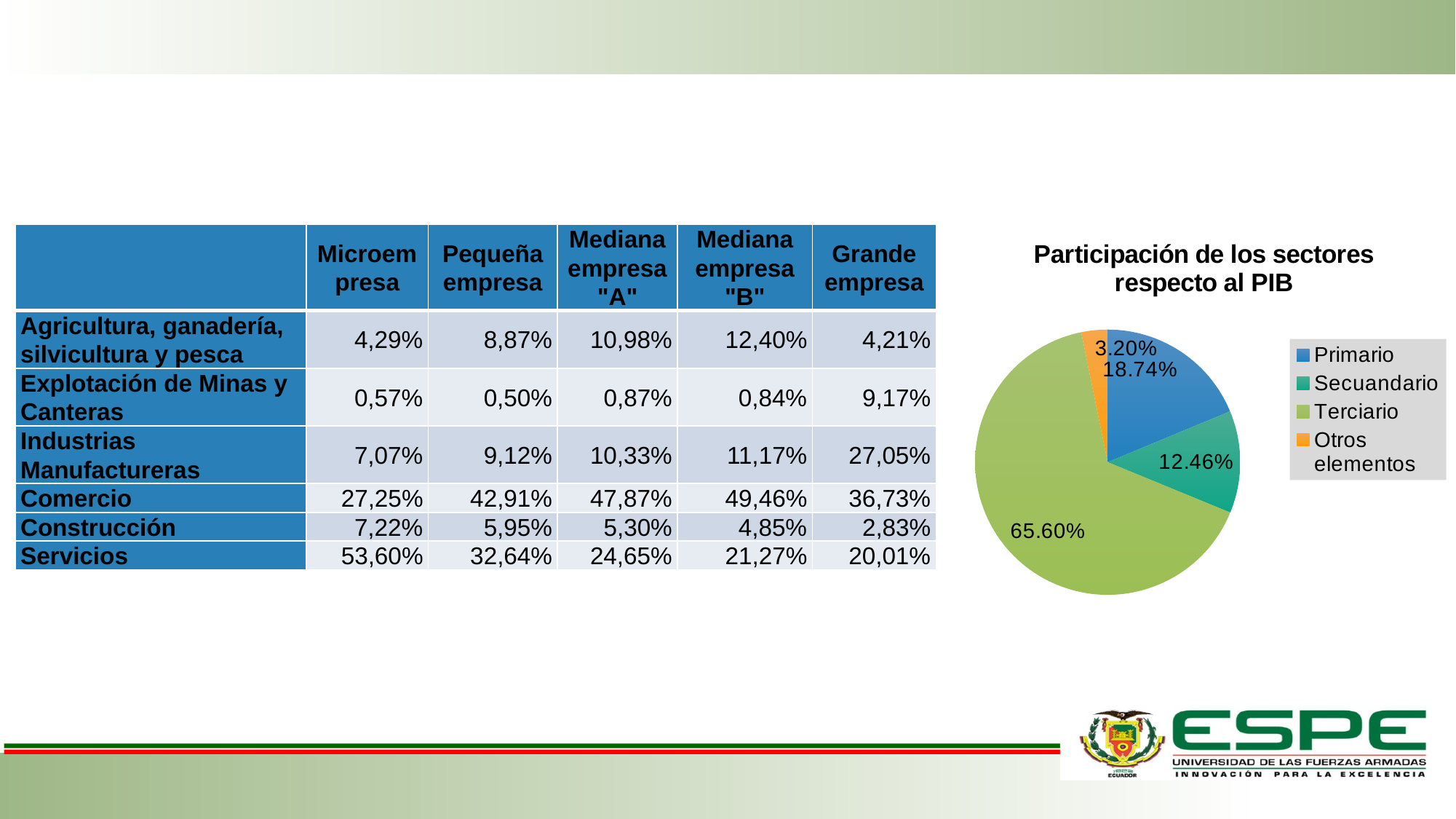
Which colour represents Terciario in the pie chart? Green What kind of chart is shown on the slide? Pie chart In the pie chart, what is the value for Secuandario? 12.46% In the pie chart, what is the difference between the Primario and Secuandario values? 6.28% How many slices does the pie chart have? 4 In the pie chart, what is the value for Primario? 18.74% What is the title of the pie chart? Participación de los sectores respecto al PIB In the pie chart, what is the value for Terciario? 65.60% Which sector has the largest slice in the pie chart? Terciario In the pie chart, which is larger: Primario or Secuandario? Primario In the pie chart, what is the value for Otros elementos? 3.20% Which sector has the smallest slice in the pie chart? Otros elementos